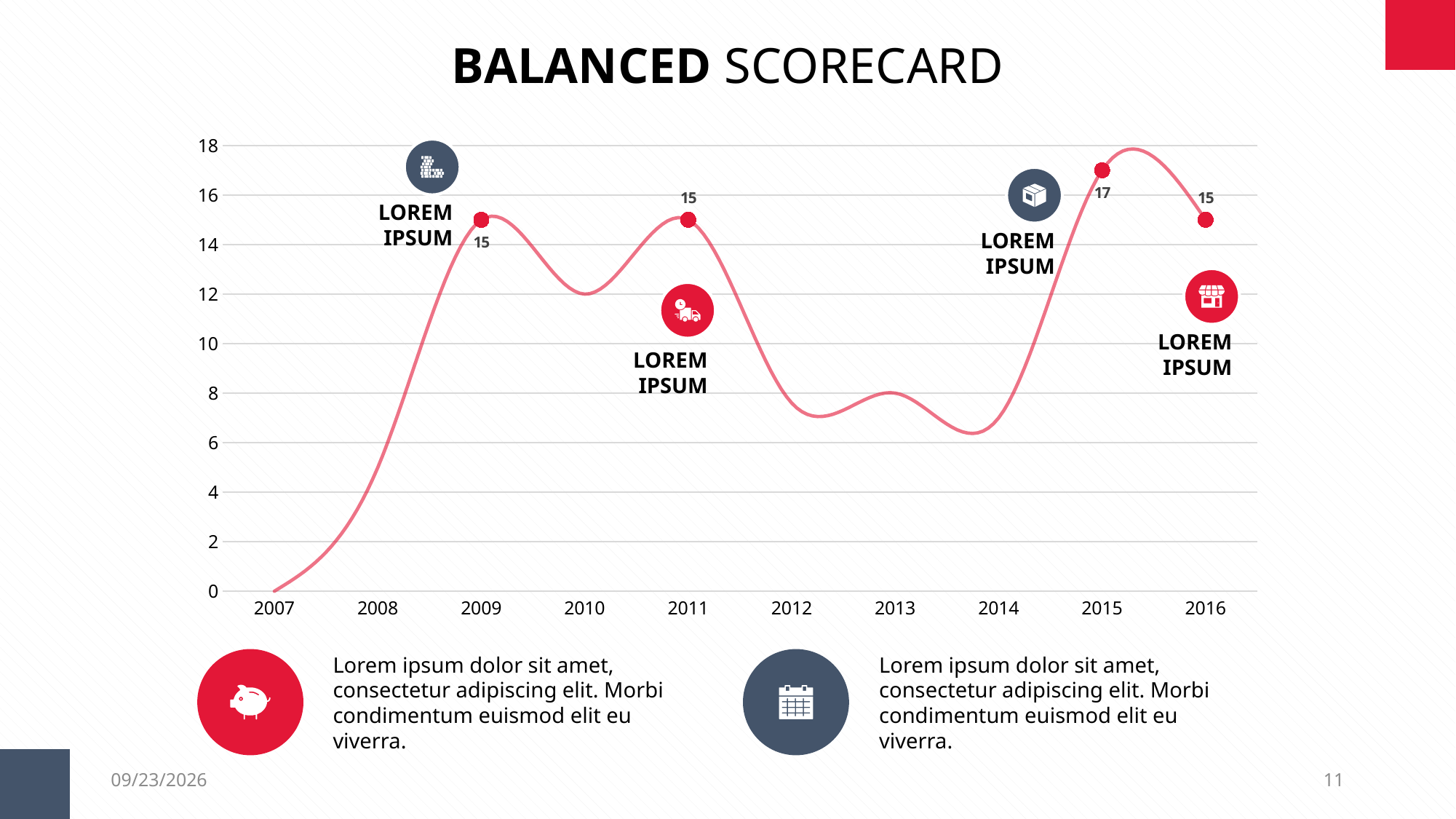
Which year has the highest labelled value? 2015 Is the value for 2008 greater or less than 6? less What is the title of the slide? BALANCED SCORECARD What is the value for 2009? 15 How many years are shown on the x axis? 10 What is the value for 2016? 15 Is the value for 2014 greater or less than 10? less Which is larger, the value for 2015 or the value for 2009? 2015 What is the value for 2011? 15 What kind of chart is shown on the slide? line chart What is the value for 2015? 17 What is the difference between the values for 2015 and 2016? 2